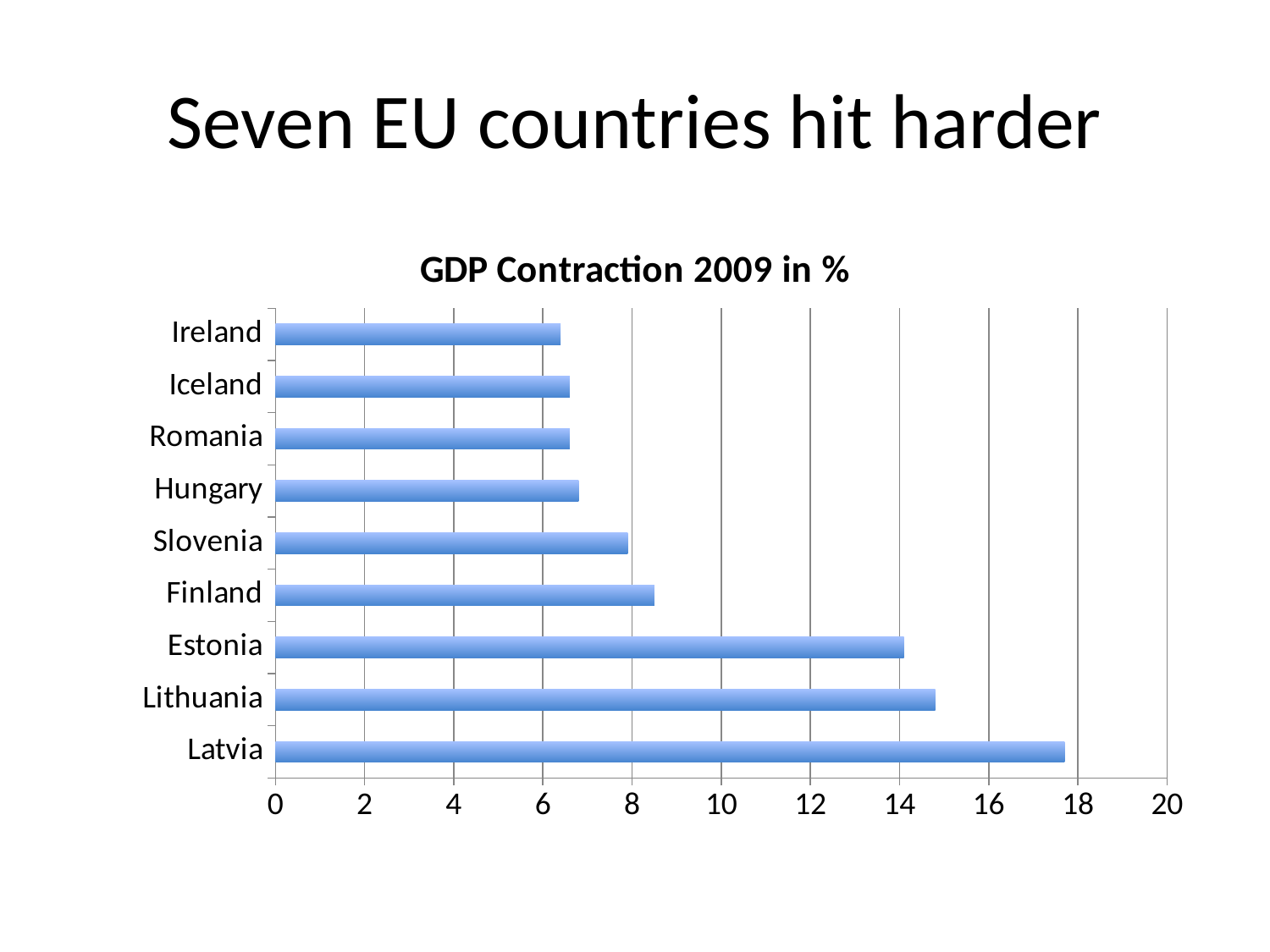
Is the value for Finland greater or less than 8? greater Which has a larger GDP contraction, Latvia or Estonia? Latvia What kind of chart is shown on the slide? bar chart Which country has the highest GDP contraction in the chart? Latvia Which has a larger GDP contraction, Finland or Hungary? Finland Is the value for Ireland greater or less than 6? greater Is the value for Lithuania greater or less than 16? less How many countries are shown in the chart? 9 What is the title of the chart? GDP Contraction 2009 in %